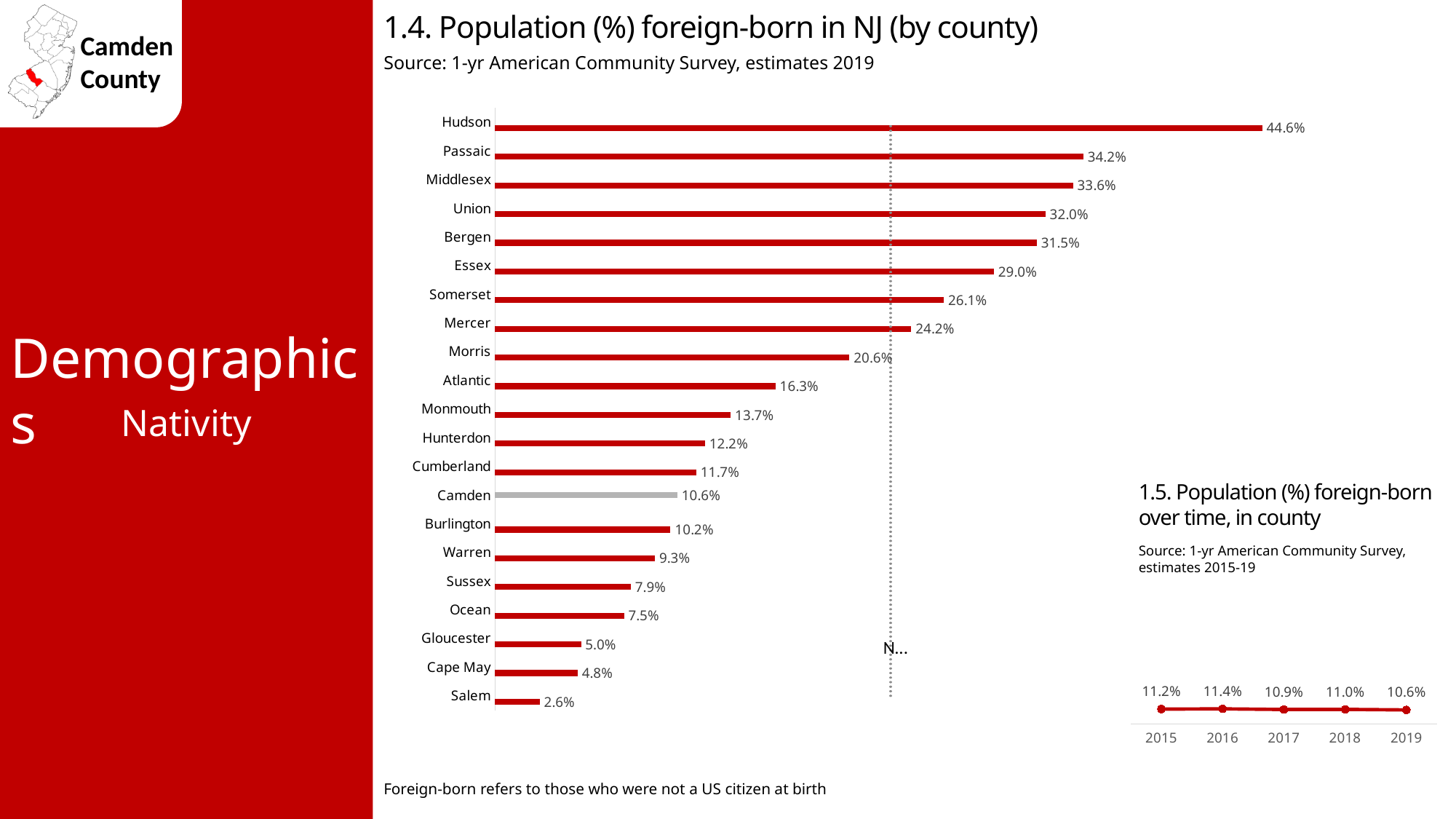
In the chart '1.4. Population (%) foreign-born in NJ (by county)', how many counties are shown? 21 In the chart '1.4. Population (%) foreign-born in NJ (by county)', what is the value for Gloucester? 5.0% In the chart '1.4. Population (%) foreign-born in NJ (by county)', what is the difference between the values for Hudson and Passaic? 10.4% In the chart '1.4. Population (%) foreign-born in NJ (by county)', which county has the lowest value? Salem In the chart '1.4. Population (%) foreign-born in NJ (by county)', which county has the highest value? Hudson In the chart '1.4. Population (%) foreign-born in NJ (by county)', which is larger, the value for Bergen or the value for Essex? Bergen In the chart '1.5. Population (%) foreign-born over time, in county', do the values generally rise or fall from 2015 to 2019? Fall In the chart '1.5. Population (%) foreign-born over time, in county', what is the value for 2016? 11.4% In the chart '1.4. Population (%) foreign-born in NJ (by county)', which bar is coloured grey instead of red? Camden What kind of chart is '1.4. Population (%) foreign-born in NJ (by county)'? Bar chart In the chart '1.5. Population (%) foreign-born over time, in county', how many years are plotted? 5 In the chart '1.4. Population (%) foreign-born in NJ (by county)', what is the value for Camden? 10.6%